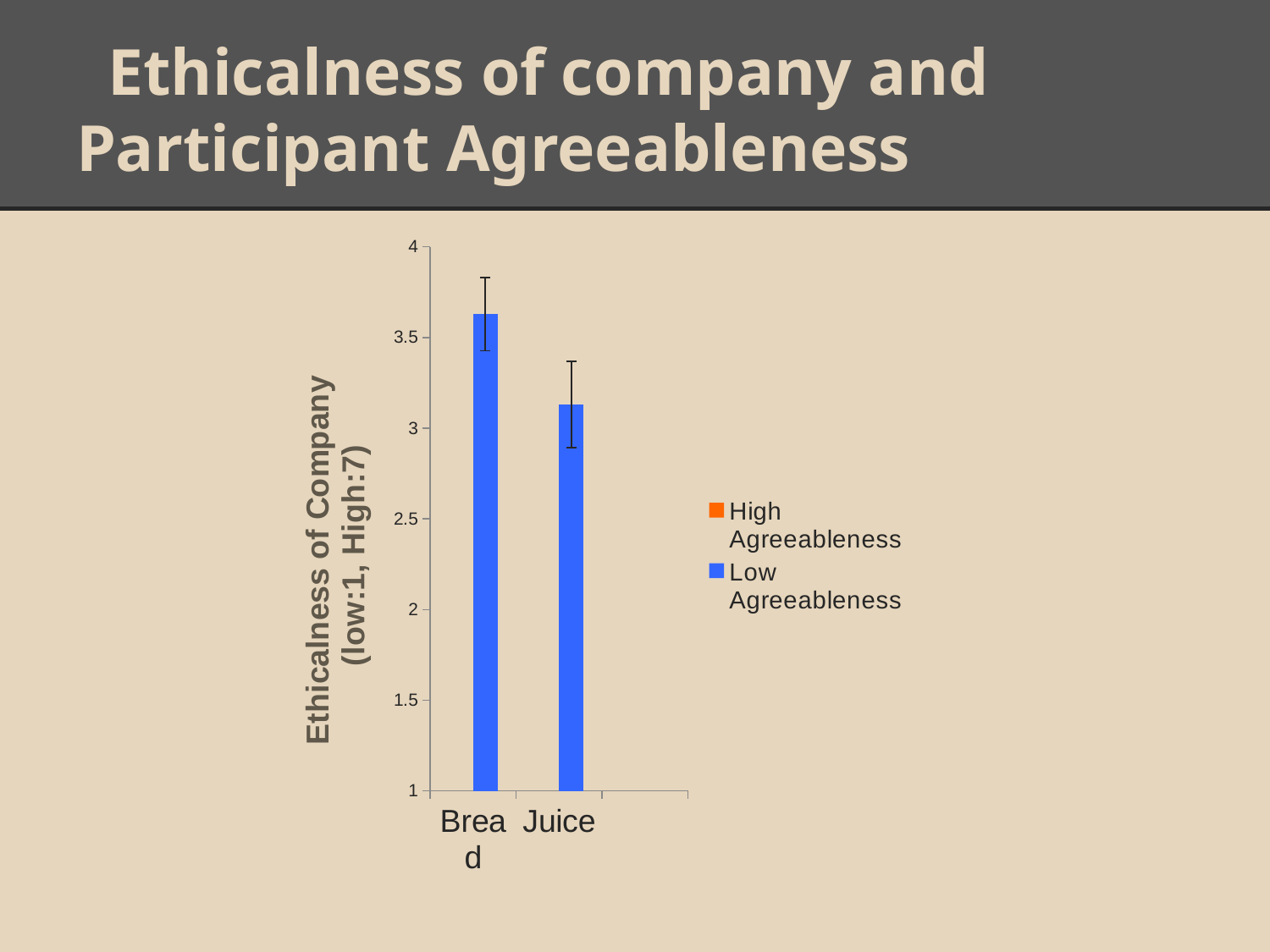
Is the Low Agreeableness value for Juice greater or less than 3? greater Which colour does the legend assign to Low Agreeableness? blue Is the Low Agreeableness value for Bread larger or smaller than the value for Juice? larger Is the Low Agreeableness value for Bread greater or less than 4? less Is the Low Agreeableness value for Juice greater or less than 3.5? less What kind of chart is shown on the slide? bar chart What is the title of the y axis? Ethicalness of Company (low:1, High:7) Which category has the lower Low Agreeableness bar? Juice How many categories are labelled on the x axis? 2 Which category has the higher Low Agreeableness bar, Bread or Juice? Bread How many series does the legend list? 2